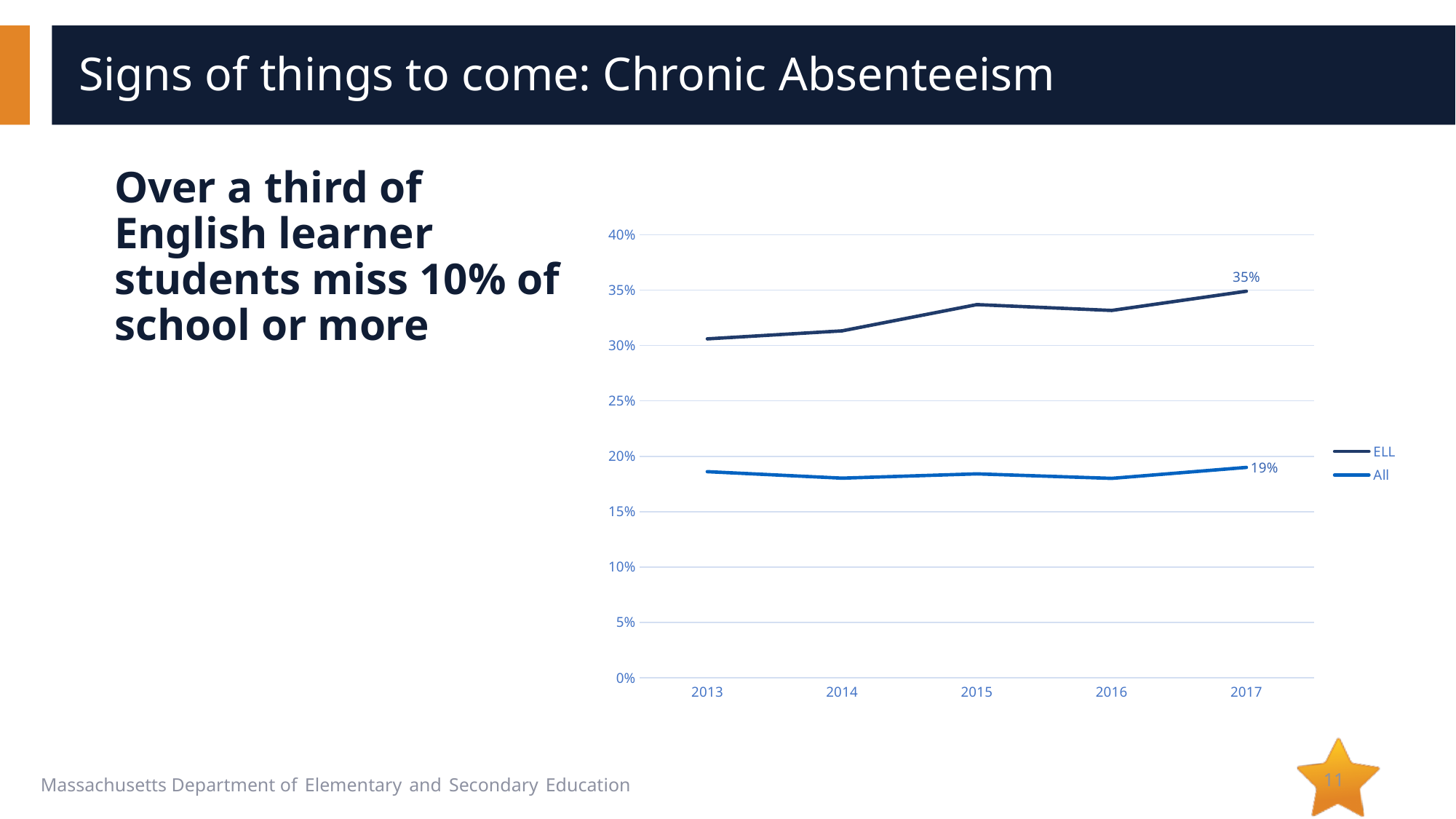
Is the value for ELL in 2013 greater or less than 30%? greater Is the value for All in 2014 greater or less than 20%? less What is the value for ELL in 2017? 35% What are the two series named in the legend? ELL and All Which series has the higher value in 2017, ELL or All? ELL How many years are shown on the x axis? 5 What is the difference between the ELL and All values in 2017? 16% Does the ELL line generally rise or fall from 2013 to 2017? Rise What kind of chart is shown on the slide? Line chart How many series does the legend list? 2 What is the value for All in 2017? 19% Is the value for ELL in 2015 greater or less than 35%? less